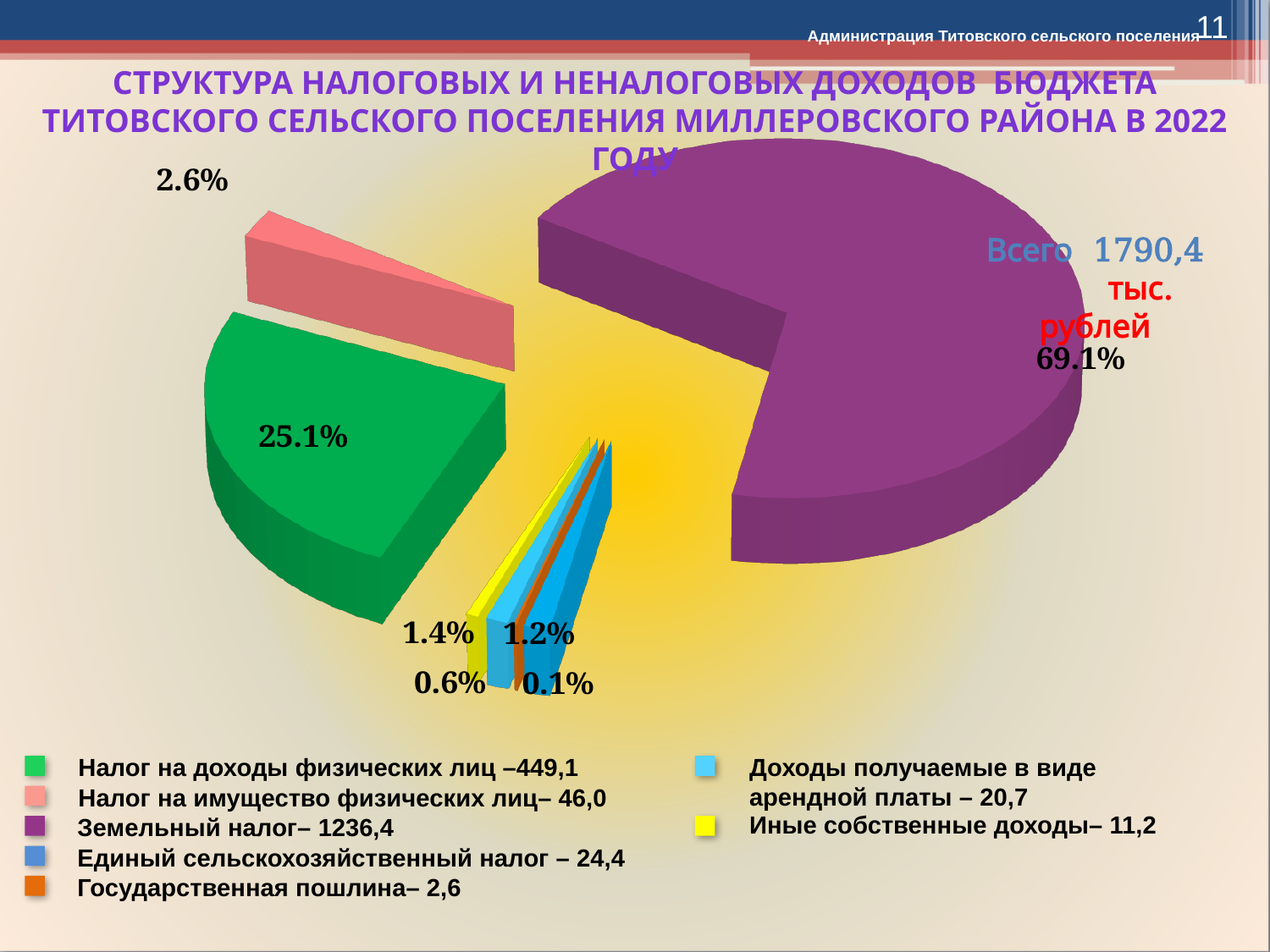
What is the difference between the legend values for Земельный налог (1236,4) and Налог на доходы физических лиц (449,1)? 787,3 What share of the pie does Налог на имущество физических лиц have? 2.6% What value is given in the legend for Единый сельскохозяйственный налог? 24,4 What kind of chart is shown on the slide? pie chart Which category has the smallest value in the legend? Государственная пошлина Which category has the largest slice of the pie? Земельный налог Which is larger: Налог на доходы физических лиц or Налог на имущество физических лиц? Налог на доходы физических лиц How many categories does the legend of the pie chart list? 7 What value is given in the legend for Доходы получаемые в виде арендной платы? 20,7 What share of the pie does Земельный налог have? 69.1% What total amount (Всего) is shown next to the pie chart? 1790,4 тыс. рублей What share of the pie does Налог на доходы физических лиц have? 25.1%